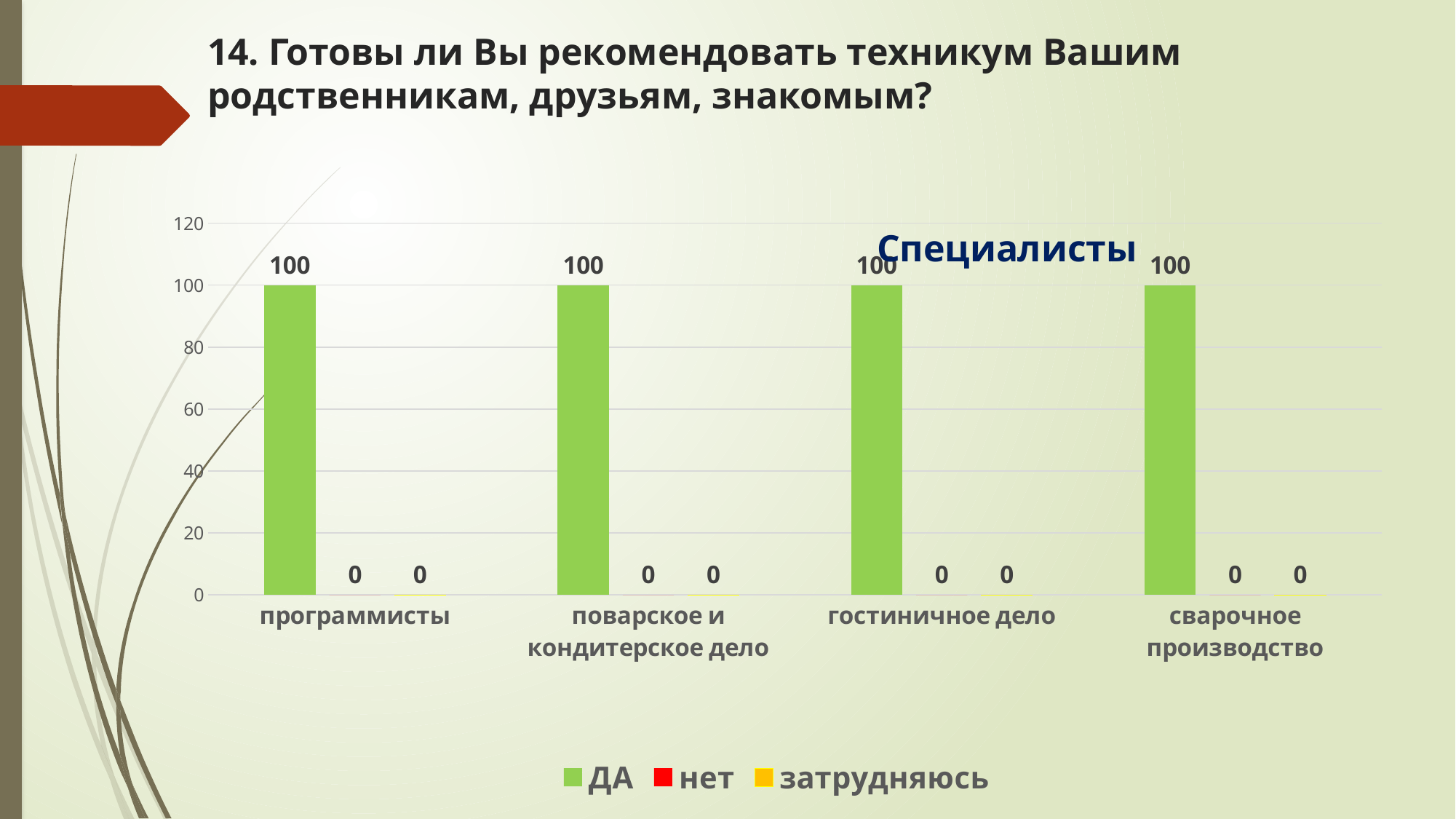
Which colour represents the ДА series in the legend? green What is the difference between the ДА value and the нет value for программисты? 100 How many categories are shown on the x axis? 4 How many series does the legend list? 3 What is the value of the затрудняюсь series for сварочное производство? 0 Which series has the highest value for сварочное производство? ДА What kind of chart is shown on the slide? bar chart What is the value of the нет series for гостиничное дело? 0 What is the value of the ДА series for программисты? 100 What label appears in blue text above the chart? Специалисты What is the value of the ДА series for поварское и кондитерское дело? 100 Is the ДА value for гостиничное дело greater or less than 80? greater